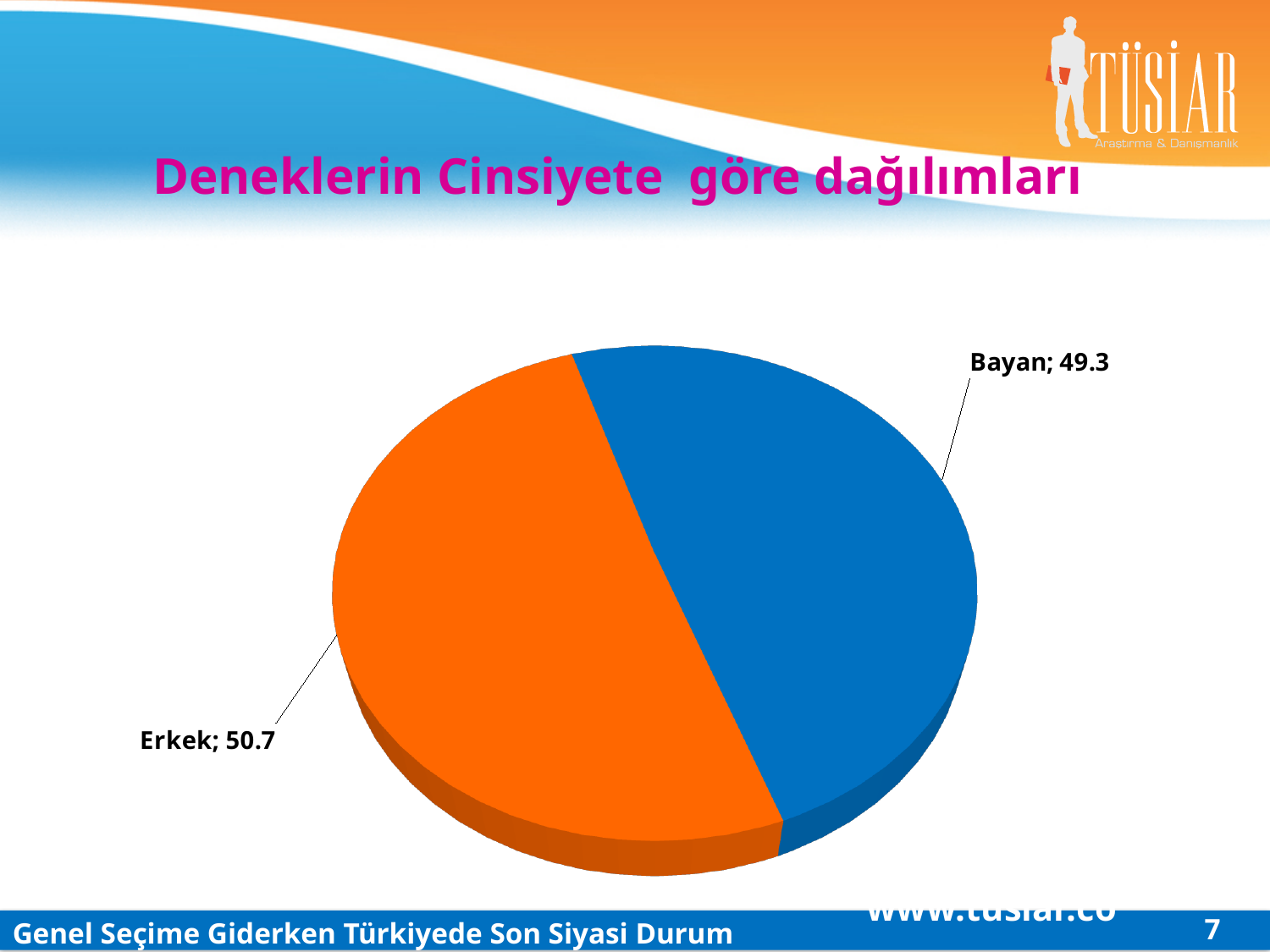
What is the title of the chart on the slide? Deneklerin Cinsiyete göre dağılımları What is the value shown for Bayan? 49.3 What colour is the slice for Erkek? Orange Which category has the larger value, Bayan or Erkek? Erkek What is the value shown for Erkek? 50.7 What is the difference between the values for Erkek and Bayan? 1.4 What is the sum of the two values shown in the pie chart? 100 How many categories are shown in the pie chart? 2 Which category has the smallest slice of the pie? Bayan Which category has the largest slice of the pie? Erkek What kind of chart is shown on the slide? Pie chart